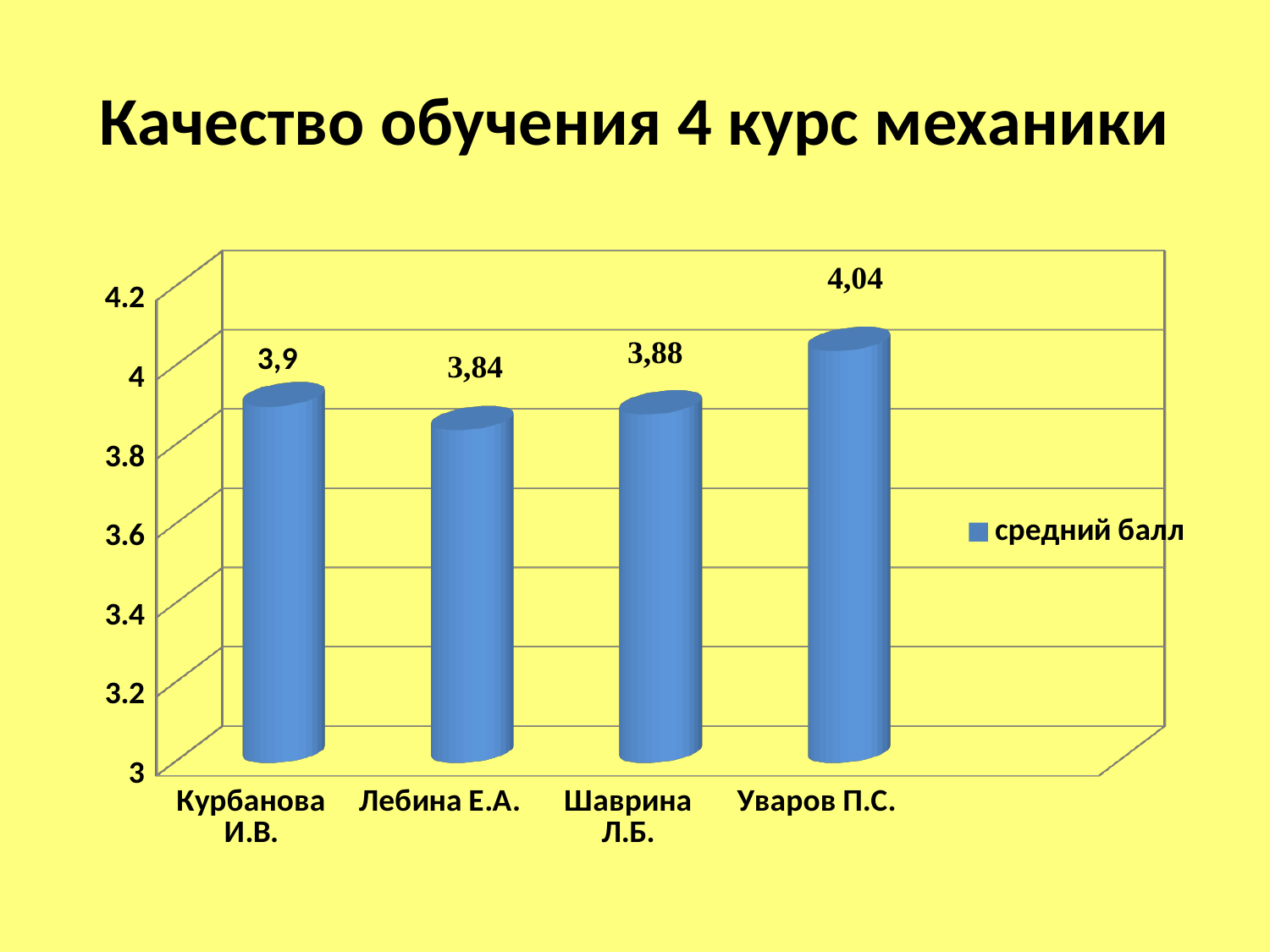
What is the difference between the average scores of Уваров П.С. and Лебина Е.А.? 0,2 Which teacher has the lowest average score? Лебина Е.А. What is the average score for Лебина Е.А.? 3,84 What is the average score (средний балл) for Курбанова И.В.? 3,9 How many teachers are shown on the chart? 4 Who has a higher average score, Курбанова И.В. or Шаврина Л.Б.? Курбанова И.В. What kind of chart is shown on the slide? bar chart What is the average score for Уваров П.С.? 4,04 Which teacher has the highest average score? Уваров П.С. Is the value for Уваров П.С. greater or less than 4? greater What is the average score for Шаврина Л.Б.? 3,88 What is the title of the slide? Качество обучения 4 курс механики